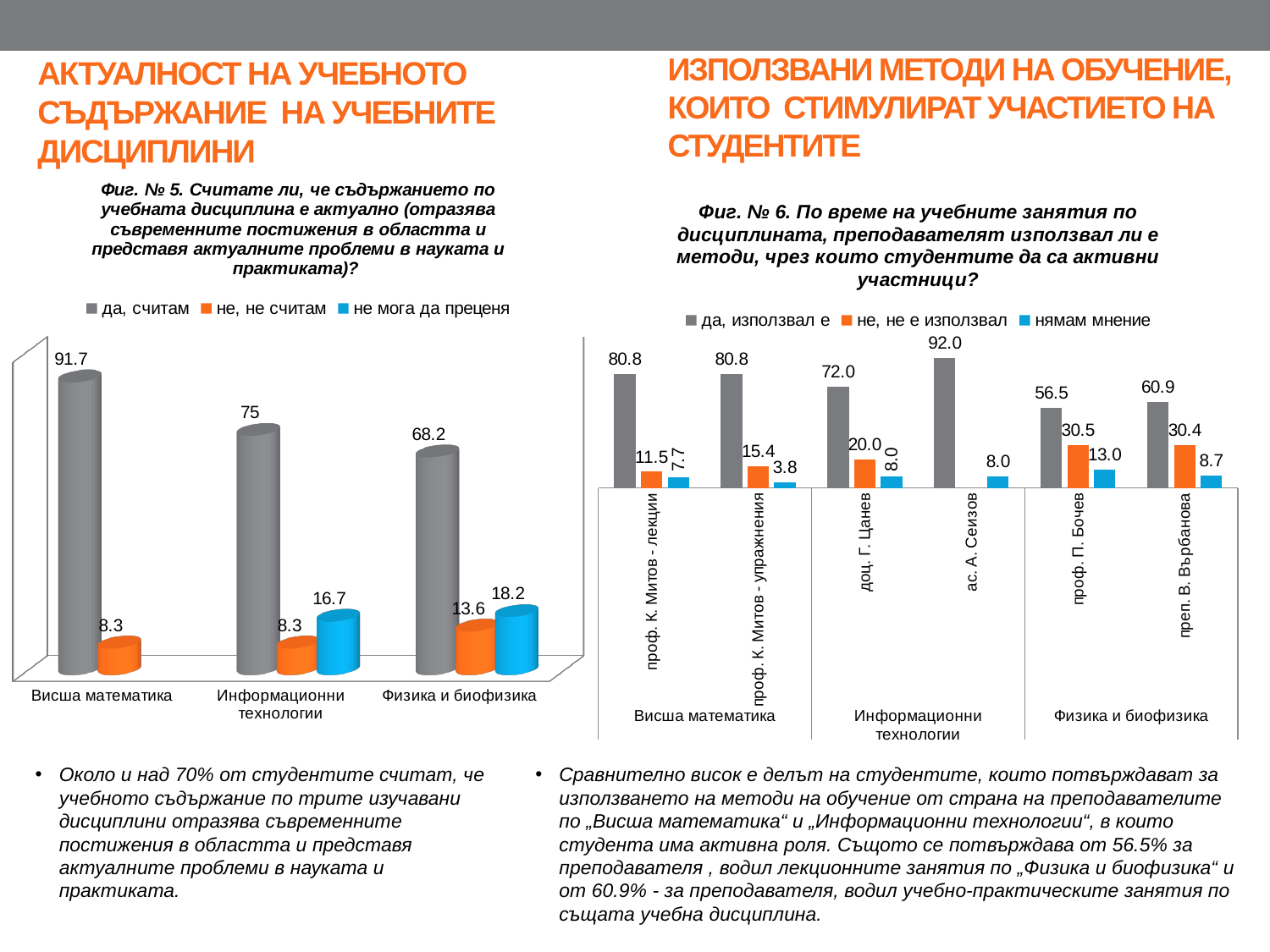
In the left chart (Фиг. № 5), what is the value of "не мога да преценя" for Физика и биофизика? 18.2 In the right chart (Фиг. № 6), what is the difference between the "да, използвал е" values for ас. А. Сеизов and проф. П. Бочев? 35.5 In the right chart (Фиг. № 6), which lecturer has the lowest value for "да, използвал е"? проф. П. Бочев In the right chart (Фиг. № 6), what is the value of "да, използвал е" for ас. А. Сеизов? 92.0 In the left chart (Фиг. № 5), what kind of chart is shown? Bar chart In the right chart (Фиг. № 6), is the "да, използвал е" value larger for доц. Г. Цанев or for преп. В. Върбанова? доц. Г. Цанев In the right chart (Фиг. № 6), how many lecturer categories are shown? 6 In the left chart (Фиг. № 5), what is the value of "да, считам" for Висша математика? 91.7 In the left chart (Фиг. № 5), which category has the highest value for "да, считам"? Висша математика In the left chart (Фиг. № 5), how many series does the legend list? 3 In the left chart (Фиг. № 5), what is the difference between the "да, считам" values for Висша математика and Физика и биофизика? 23.5 In the right chart (Фиг. № 6), what is the value of "не, не е използвал" for проф. П. Бочев? 30.5